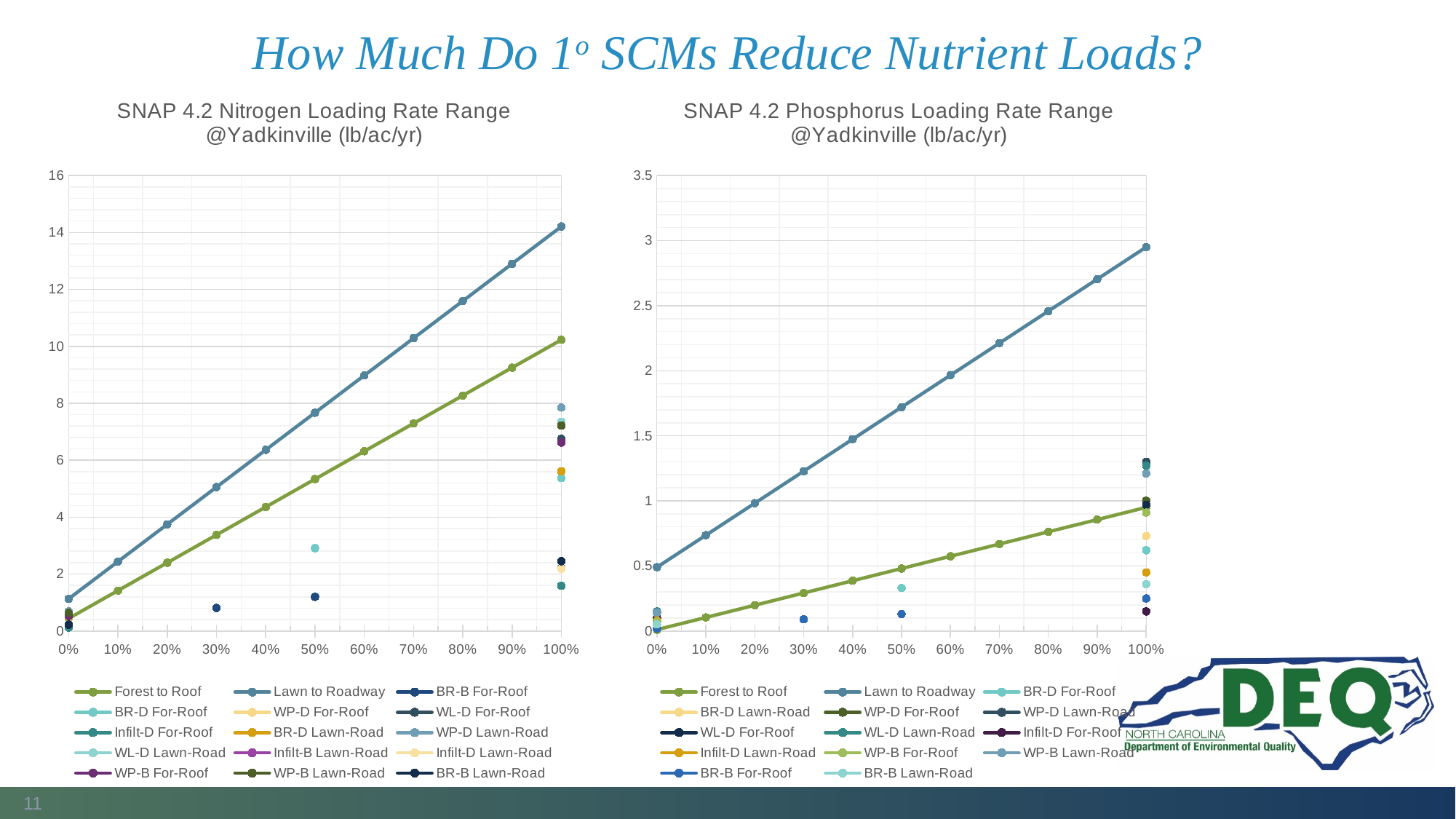
In the SNAP 4.2 Nitrogen Loading Rate Range chart, which series is higher at 100%: Lawn to Roadway or Forest to Roof? Lawn to Roadway How many series does the legend of the SNAP 4.2 Nitrogen Loading Rate Range chart list? 15 In the SNAP 4.2 Nitrogen Loading Rate Range chart, is the Forest to Roof value at 50% greater or less than 6? less In the SNAP 4.2 Phosphorus Loading Rate Range chart, is the Lawn to Roadway value at 50% greater or less than 1.5? greater In the SNAP 4.2 Phosphorus Loading Rate Range chart, is the Forest to Roof value at 100% greater or less than 0.5? greater In the SNAP 4.2 Nitrogen Loading Rate Range chart, does the Lawn to Roadway series rise or fall as the x axis goes from 0% to 100%? rise In the SNAP 4.2 Phosphorus Loading Rate Range chart, does the Forest to Roof series rise or fall from 0% to 100%? rise How many x-axis categories (percentage points) are shown on the SNAP 4.2 Phosphorus Loading Rate Range chart? 11 What type of chart is the SNAP 4.2 Nitrogen Loading Rate Range chart? line chart